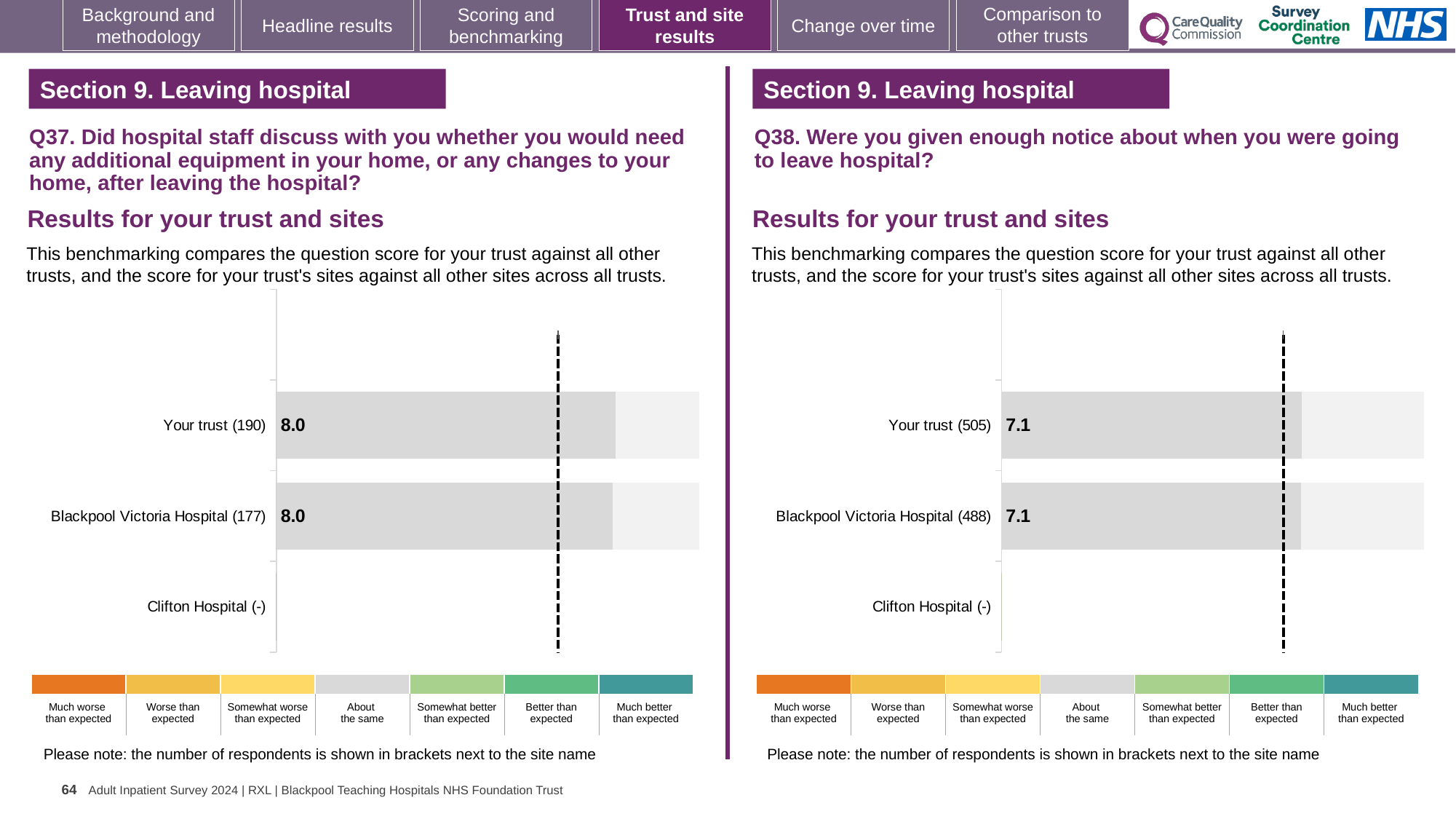
In the Q38 chart on the right, what is the score for Blackpool Victoria Hospital? 7.1 What kind of chart is the Q37 chart on the left? Bar chart In the Q38 chart on the right, how many respondents are shown in brackets for Blackpool Victoria Hospital? 488 In the Q37 chart on the left, how many respondents are shown in brackets for Your trust? 190 In the Q37 chart on the left, what is the score for Your trust? 8.0 In the Q37 chart on the left, what is the score for Blackpool Victoria Hospital? 8.0 In the Q38 chart on the right, what is the score for Your trust? 7.1 Is the score for Your trust in the Q37 chart on the left larger or smaller than the score for Your trust in the Q38 chart on the right? Larger In the Q37 chart on the left, what is the difference between the score for Your trust and the score for Blackpool Victoria Hospital? 0.0 How many categories are listed on the y axis of the Q37 chart on the left? 3 In the Q38 chart on the right, what is the difference between the score for Your trust and the score for Blackpool Victoria Hospital? 0.0 How many categories are listed on the y axis of the Q38 chart on the right? 3